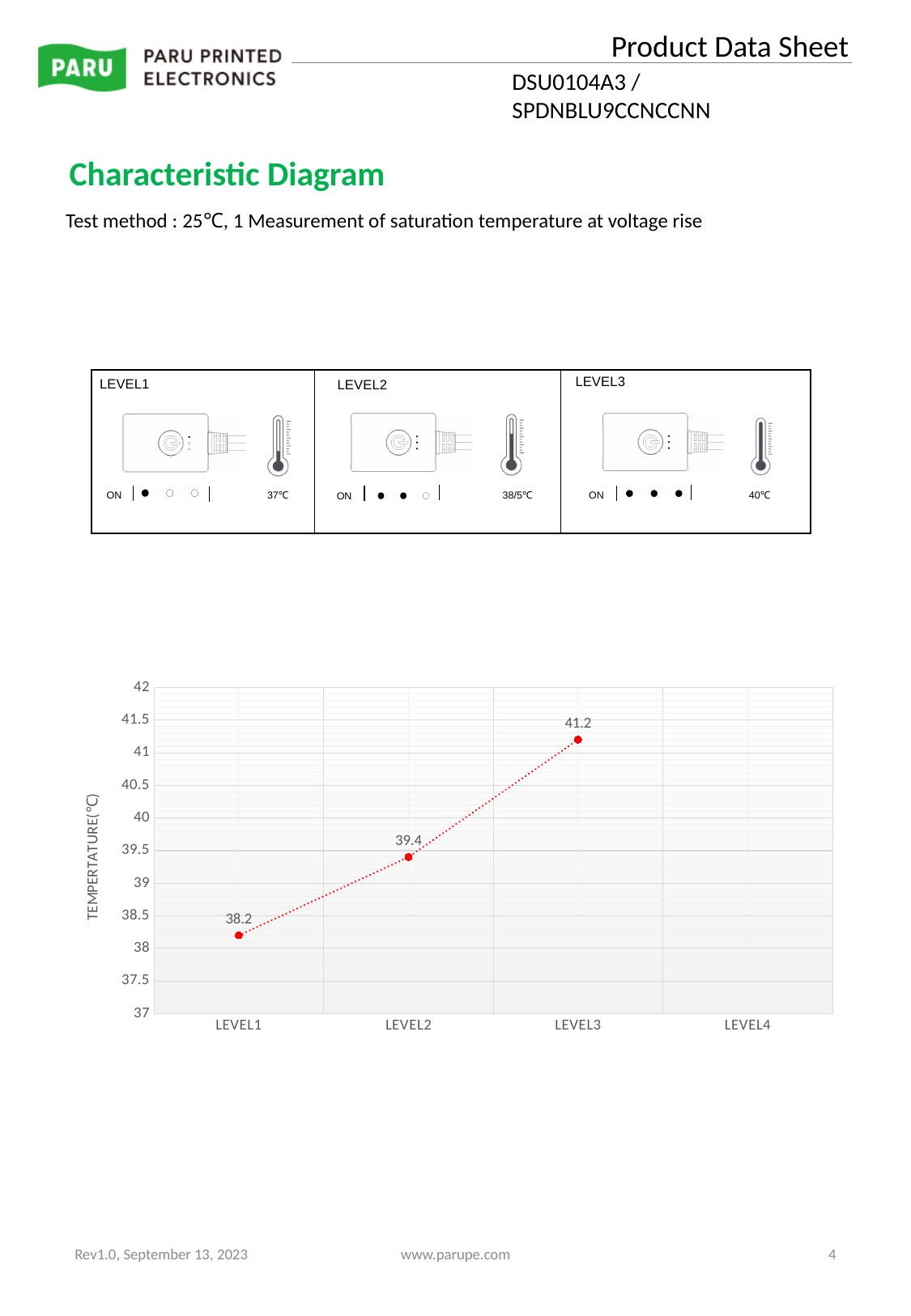
Which level has the highest plotted temperature? LEVEL3 What kind of chart is shown? line chart Which has a larger plotted value, LEVEL2 or LEVEL3? LEVEL3 What is the difference between the plotted values for LEVEL2 and LEVEL1? 1.2 Is the plotted value for LEVEL2 greater or less than 39? greater Do the plotted values rise or fall from LEVEL1 to LEVEL3? rise What is the plotted temperature value for LEVEL3? 41.2 How many data points are plotted on the chart? 3 Which level has the lowest plotted temperature? LEVEL1 What is the plotted temperature value for LEVEL1? 38.2 What is the difference between the plotted values for LEVEL3 and LEVEL1? 3 What is the plotted temperature value for LEVEL2? 39.4